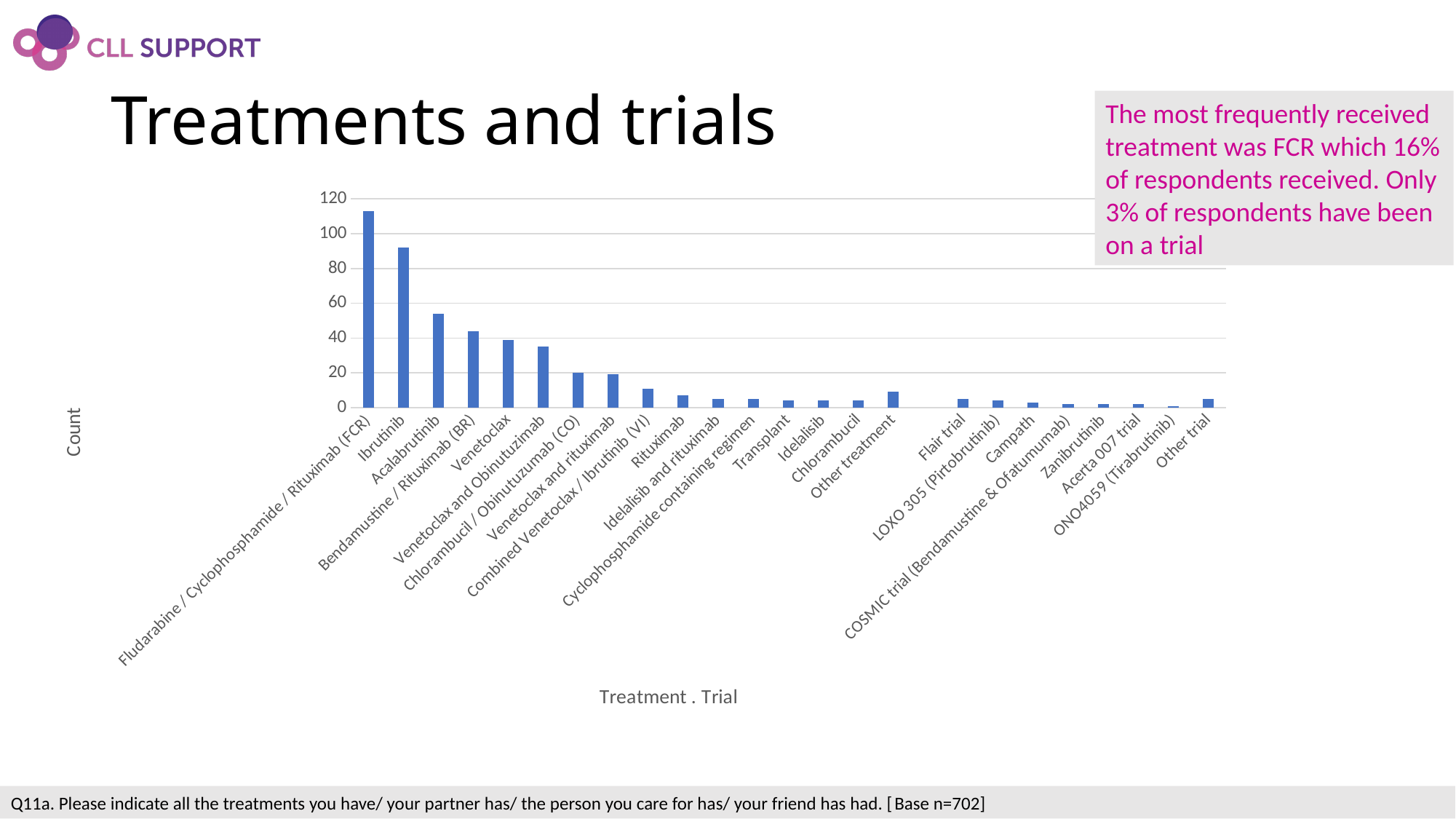
Which treatment has the highest count in the chart? Fludarabine / Cyclophosphamide / Rituximab (FCR) Is the value for Acalabrutinib greater or less than 40? greater What kind of chart is shown on the slide? bar chart Is the value for Fludarabine / Cyclophosphamide / Rituximab (FCR) greater or less than 100? greater Is the value for Rituximab greater or less than 20? less Which has a higher count, Ibrutinib or Acalabrutinib? Ibrutinib Do the bar values generally rise or fall from left to right across the treatments? fall What is the label on the vertical axis of the chart? Count Which has a higher count, Bendamustine / Rituximab (BR) or Chlorambucil / Obinutuzumab (CO)? Bendamustine / Rituximab (BR) What is the label on the horizontal axis of the chart? Treatment . Trial